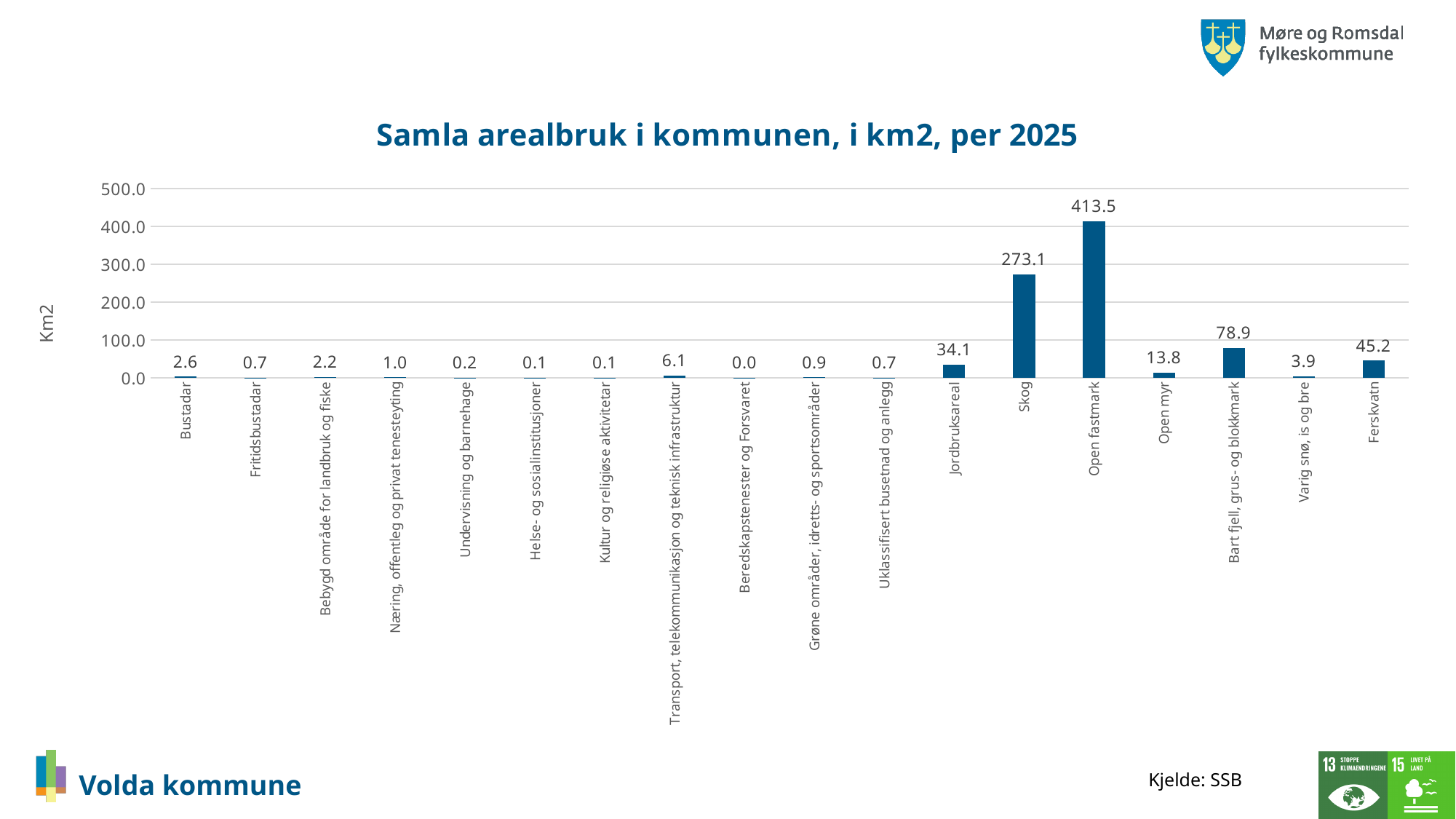
What is the difference between the values for Bart fjell, grus- og blokkmark and Ferskvatn? 33.7 What is the difference between the values for Open fastmark and Skog? 140.4 What is the title of the chart? Samla arealbruk i kommunen, i km2, per 2025 Which category has the highest value? Open fastmark Which is larger, the value for Open myr or the value for Jordbruksareal? Jordbruksareal What is the value for Ferskvatn? 45.2 What is the value for Skog? 273.1 What is the value for Transport, telekommunikasjon og teknisk infrastruktur? 6.1 What kind of chart is this? Bar chart Which category has the lowest value? Beredskapstenester og Forsvaret How many categories are shown on the x axis? 18 What is the value for Jordbruksareal? 34.1